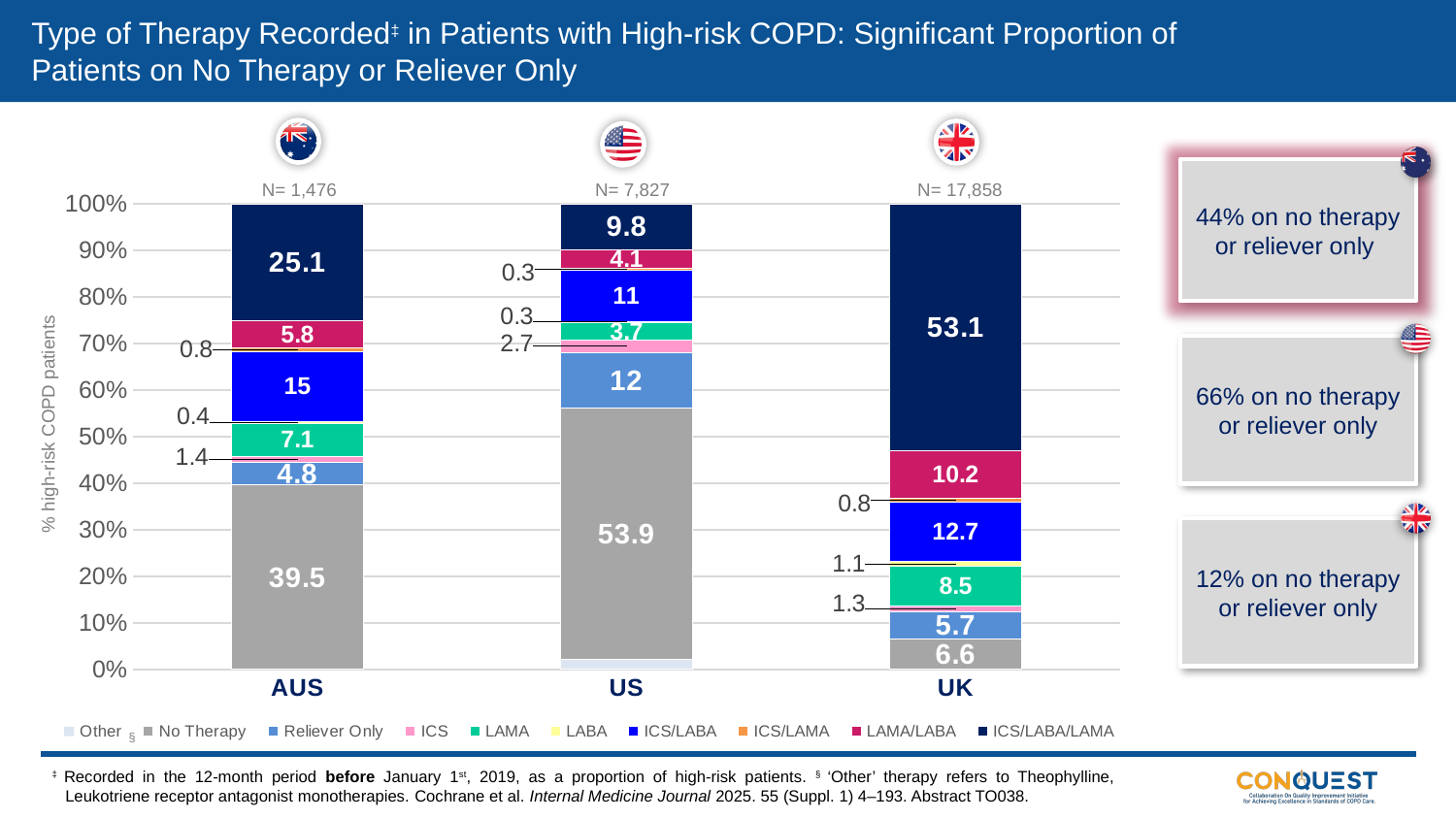
What is the value for Reliever Only in the US bar? 12 What is the difference between the No Therapy values for US and AUS? 14.4 What is the value for ICS/LABA/LAMA in the UK bar? 53.1 What percentage of high-risk COPD patients in AUS were on No Therapy? 39.5 What is the value for LAMA in the UK bar? 8.5 Which country has the highest value for No Therapy? US What is the N value shown above the UK bar? N= 17,858 How many series does the legend list? 10 Which country has the lowest value for ICS/LABA/LAMA? US How many countries are shown on the x axis? 3 What kind of chart is shown on the slide? Stacked bar chart Which is larger, the ICS/LABA value for AUS or for UK? AUS